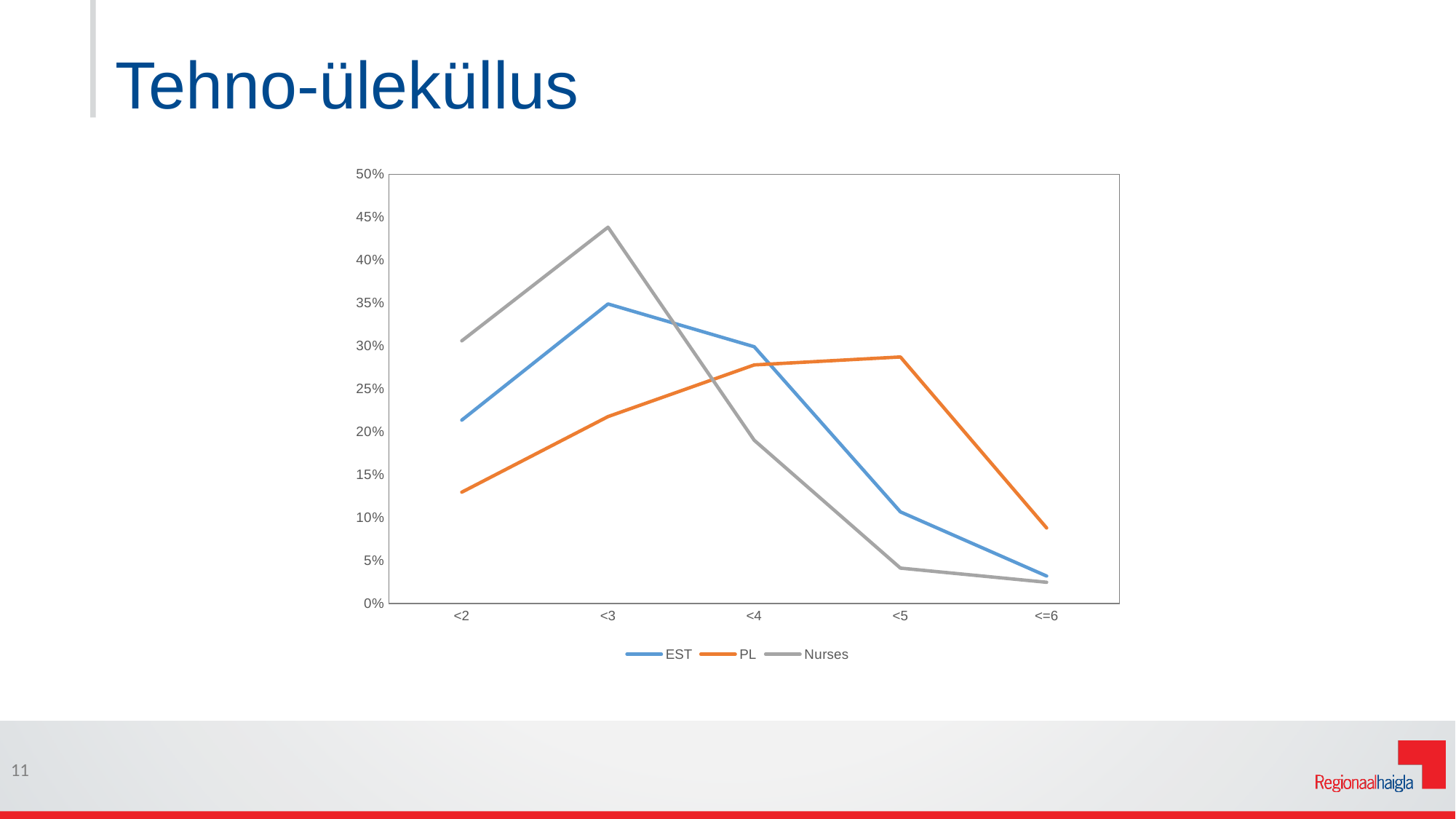
Is the value for PL at <2 greater or less than 15%? less At which category does the EST series reach its lowest value? <=6 Is the value for Nurses at <3 greater or less than 40%? greater What kind of chart is shown on the slide? line chart How many series does the legend list? 3 At which category does the Nurses series reach its highest value? <3 Does the EST series rise or fall from <3 to <=6? fall At <2, which series has the higher value, EST or PL? EST How many categories are shown on the x axis? 5 Is the value for EST at <4 greater or less than 25%? greater At <5, which series has the higher value, PL or EST? PL At which category does the EST series reach its highest value? <3